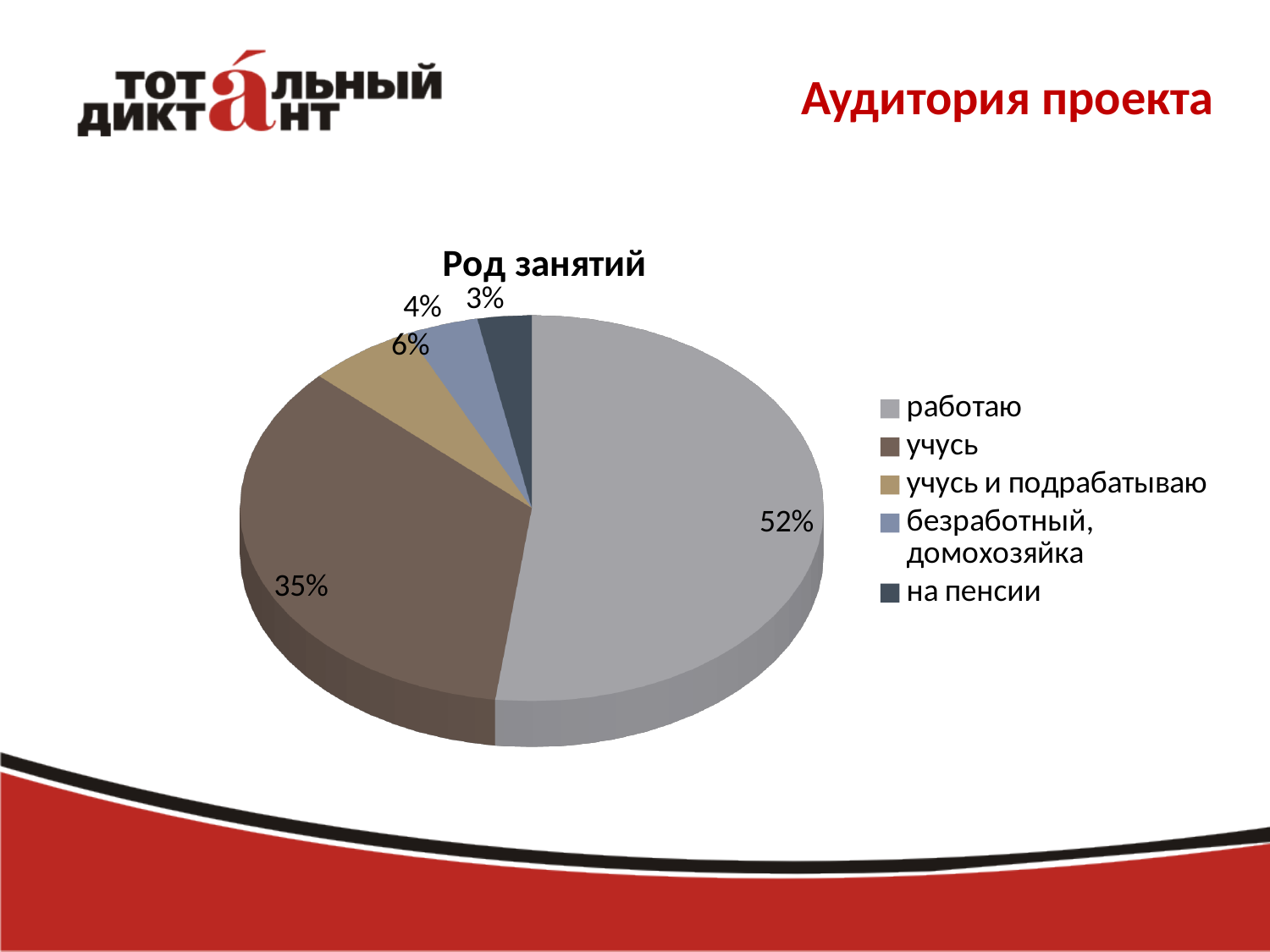
How many categories does the legend list? 5 Which category has the largest slice of the pie? работаю What is the title of the chart? Род занятий What share of the pie does "учусь и подрабатываю" have? 6% What share of the pie does "на пенсии" have? 3% Which category has the smallest slice of the pie? на пенсии What share of the pie does "учусь" have? 35% What is the difference in percentage points between "работаю" and "учусь"? 17 Which is larger: the share for "учусь и подрабатываю" or the share for "безработный, домохозяйка"? учусь и подрабатываю What type of chart is shown on the slide? Pie chart